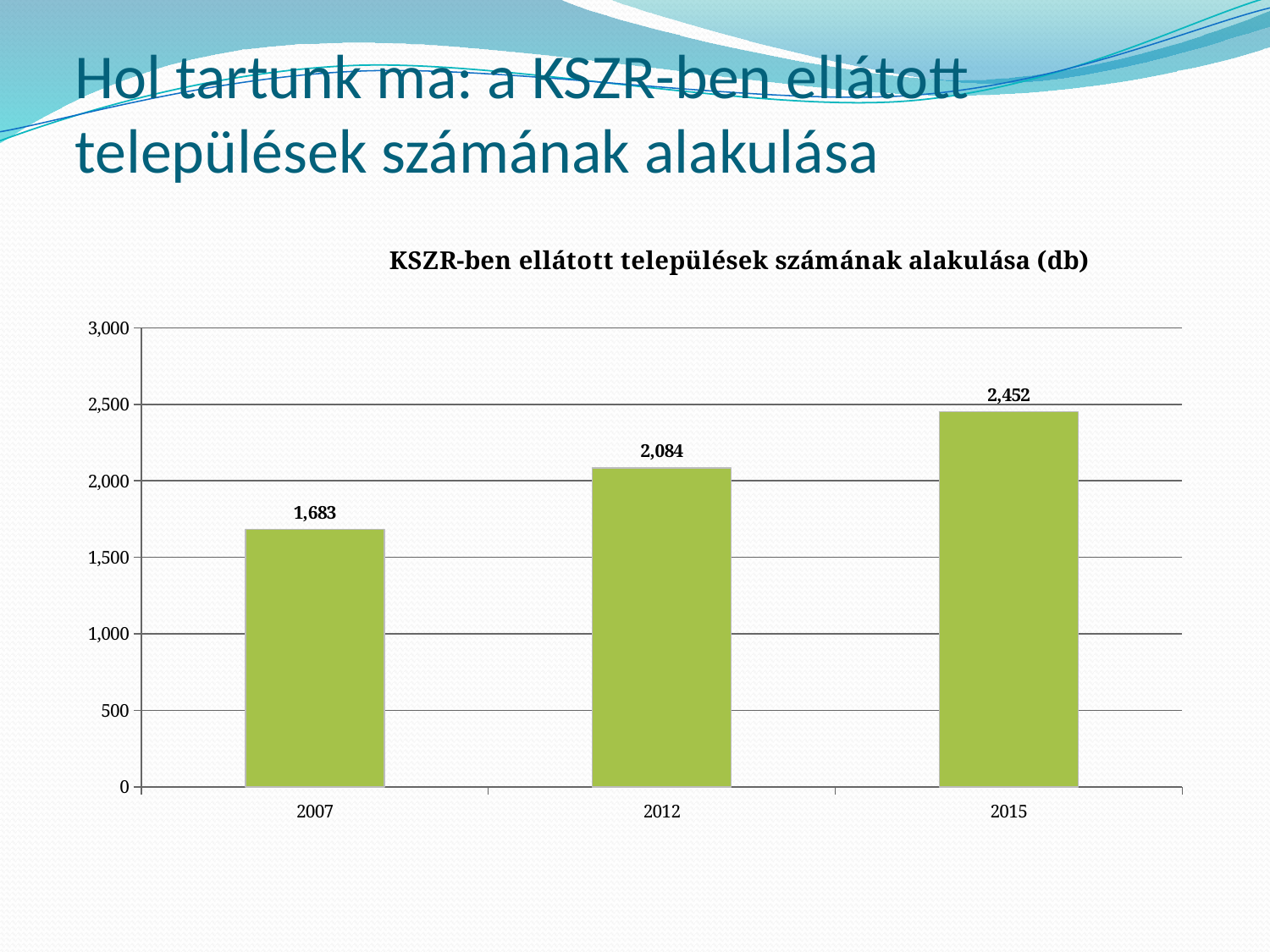
Do the values rise or fall from 2007 to 2015? rise Which year has the highest value? 2015 Which is larger, the value for 2012 or the value for 2015? 2015 What is the value for 2015? 2,452 What kind of chart is shown on the slide? bar chart What is the difference between the values for 2012 and 2007? 401 What is the value for 2007? 1,683 Is the value for 2012 greater or less than 2,000? greater How many years are shown on the x axis? 3 What is the value for 2012? 2,084 What is the difference between the values for 2015 and 2007? 769 Which year has the lowest value? 2007